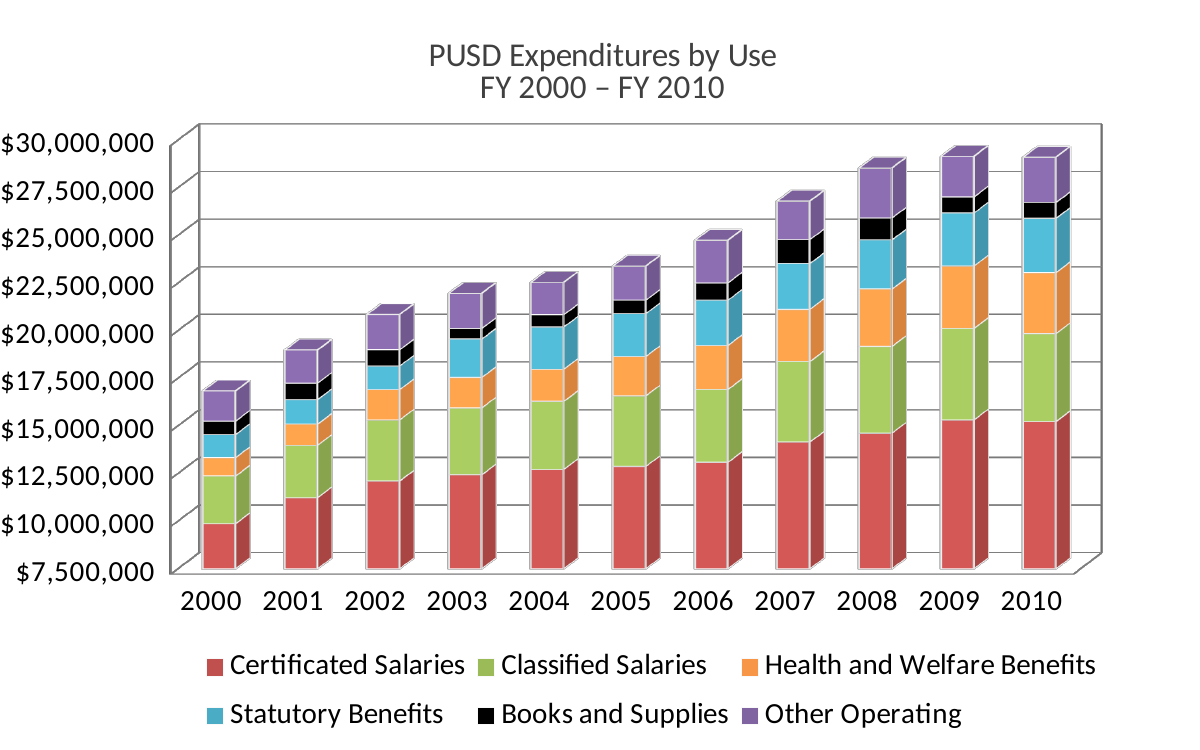
Which year has the lowest total expenditure? 2000 Which series is shown in red at the bottom of each bar? Certificated Salaries What kind of chart is shown on the slide? Stacked bar chart Which year has the larger total expenditure, 2000 or 2010? 2010 Is the Certificated Salaries value for 2010 greater or less than $12,500,000? greater What is the title of the chart? PUSD Expenditures by Use FY 2000 – FY 2010 Is the total expenditure for 2007 greater or less than $25,000,000? greater Do total expenditures generally rise or fall from 2000 to 2010? Rise Is the total expenditure for 2010 greater or less than $27,500,000? greater How many series does the legend list? 6 How many fiscal years are shown along the x axis? 11